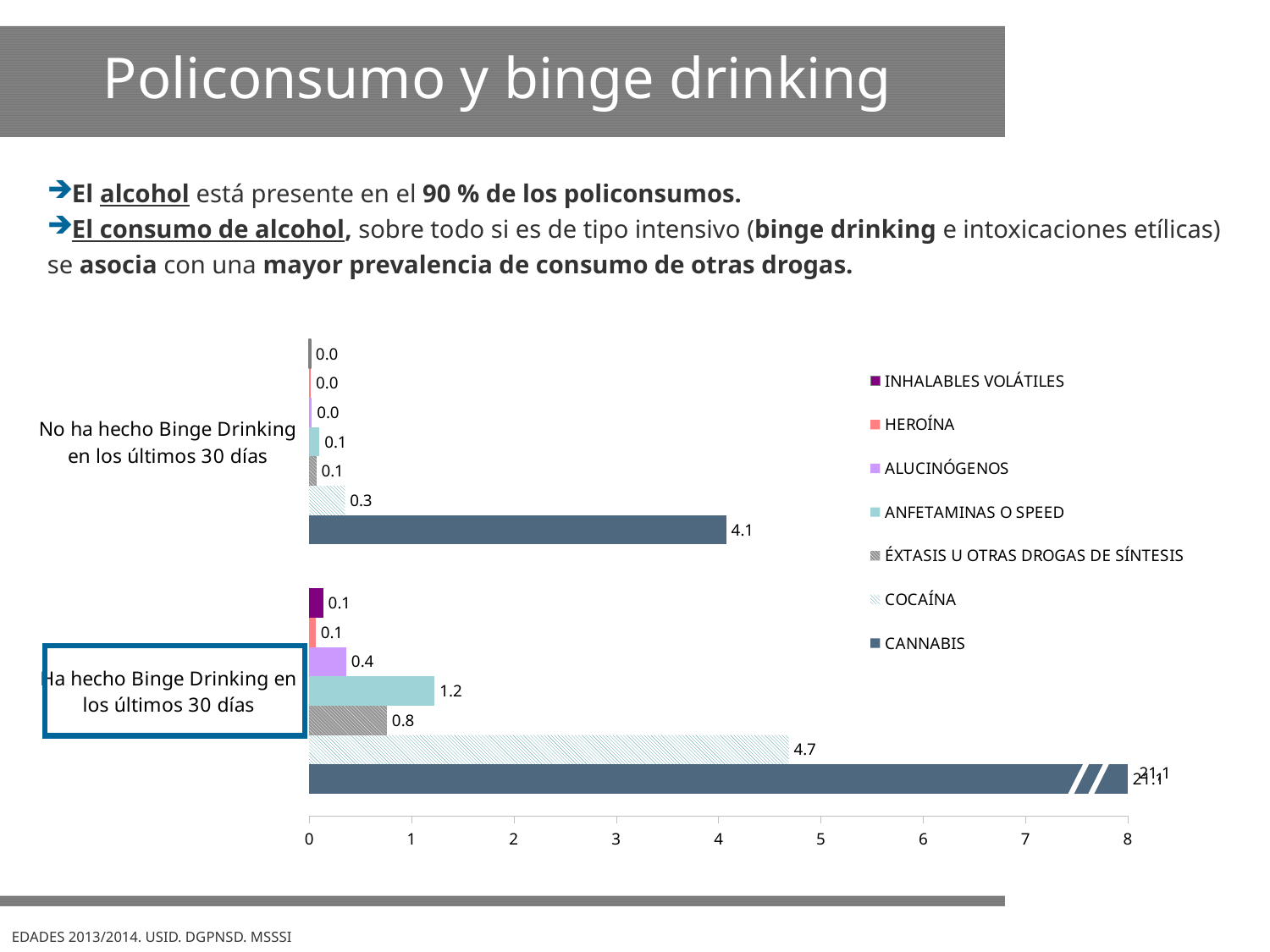
In the 'Ha hecho Binge Drinking en los últimos 30 días' group, which is larger: ANFETAMINAS O SPEED or ÉXTASIS U OTRAS DROGAS DE SÍNTESIS? ANFETAMINAS O SPEED What is the value for CANNABIS in the 'No ha hecho Binge Drinking en los últimos 30 días' group? 4.1 Which series has the highest value in the 'Ha hecho Binge Drinking en los últimos 30 días' group? CANNABIS What is the value for COCAÍNA in the 'No ha hecho Binge Drinking en los últimos 30 días' group? 0.3 What is the value for ANFETAMINAS O SPEED in the 'Ha hecho Binge Drinking en los últimos 30 días' group? 1.2 What is the value for COCAÍNA in the 'Ha hecho Binge Drinking en los últimos 30 días' group? 4.7 How many categories (groups) are shown on the chart's vertical axis? 2 What is the difference between the CANNABIS values for 'Ha hecho Binge Drinking' and 'No ha hecho Binge Drinking'? 17.0 What is the value for CANNABIS in the 'Ha hecho Binge Drinking en los últimos 30 días' group? 21.1 How many series does the legend list? 7 What is the value for ÉXTASIS U OTRAS DROGAS DE SÍNTESIS in the 'Ha hecho Binge Drinking en los últimos 30 días' group? 0.8 What kind of chart is shown on the slide? Bar chart